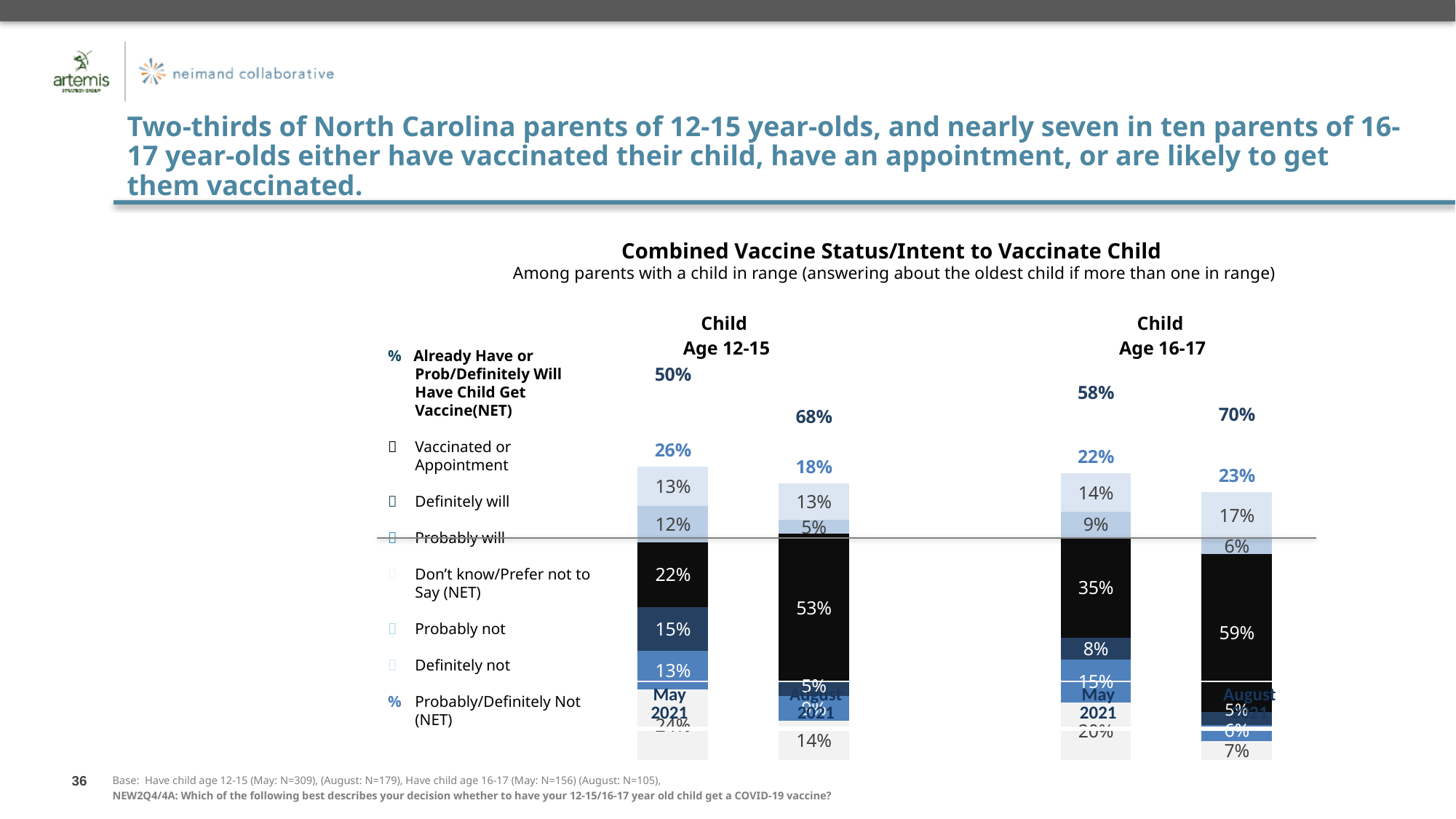
What is the 'Probably not' value for Child Age 16-17 in May 2021? 9% By how many percentage points did the 'Already Have or Prob/Definitely Will' NET for Child Age 12-15 change from May 2021 to August 2021? 18 percentage points What is the 'Vaccinated or Appointment' value for Child Age 12-15 in May 2021? 22% What is the title of the chart? Combined Vaccine Status/Intent to Vaccinate Child Which is larger in May 2021: the 'Don't know/Prefer not to Say (NET)' share for Child Age 12-15 or for Child Age 16-17? Child Age 12-15 What is the 'Already Have or Prob/Definitely Will Have Child Get Vaccine (NET)' value for Child Age 12-15 in August 2021? 68% Which bar has the highest 'Already Have or Prob/Definitely Will Have Child Get Vaccine (NET)' value? Child Age 16-17, August 2021 What percentage of parents of a child age 16-17 answered 'Don't know/Prefer not to Say (NET)' in August 2021? 7% How many bars are shown in the chart? 4 What is the 'Already Have or Prob/Definitely Will Have Child Get Vaccine (NET)' value for Child Age 16-17 in May 2021? 58% What kind of chart is shown on the slide? Stacked bar chart Did the 'Already Have or Prob/Definitely Will' NET for Child Age 16-17 rise or fall from May 2021 to August 2021? Rise